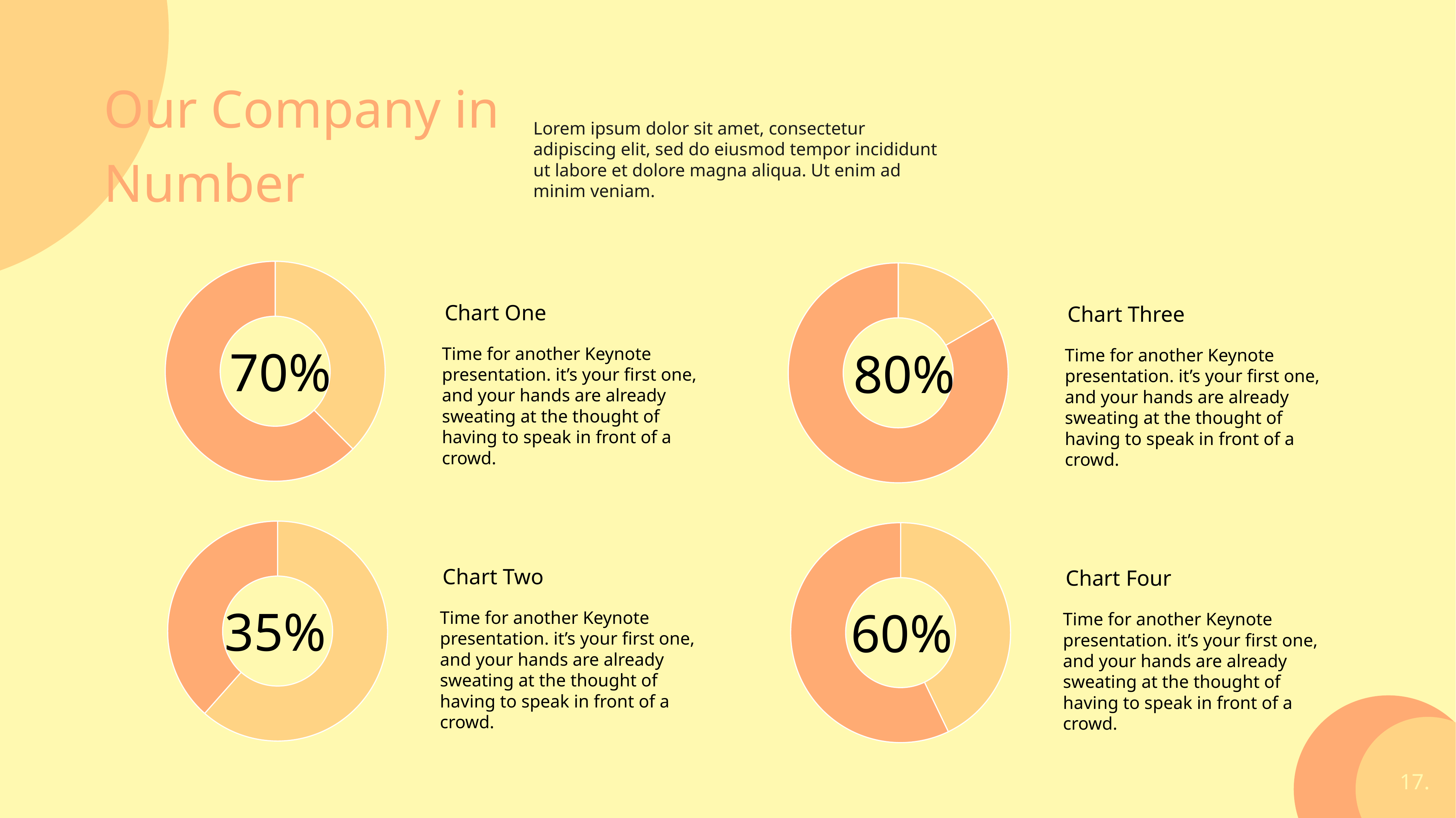
What is the difference in percentage points between Chart Three and Chart Two? 45 What is the difference in percentage points between Chart One and Chart Four? 10 What percentage is shown in the centre of Chart Two? 35% What percentage is shown in the centre of Chart Three? 80% Which of the four charts shows the highest percentage? Chart Three Which shows a larger percentage, Chart One or Chart Four? Chart One In Chart Two, is the darker orange slice larger or smaller than the lighter orange slice? Smaller What percentage is shown in the centre of Chart One? 70% What percentage is shown in the centre of Chart Four? 60% Which of the four charts shows the lowest percentage? Chart Two What kind of chart is Chart One? Donut (pie) chart How many donut charts are on the slide? 4